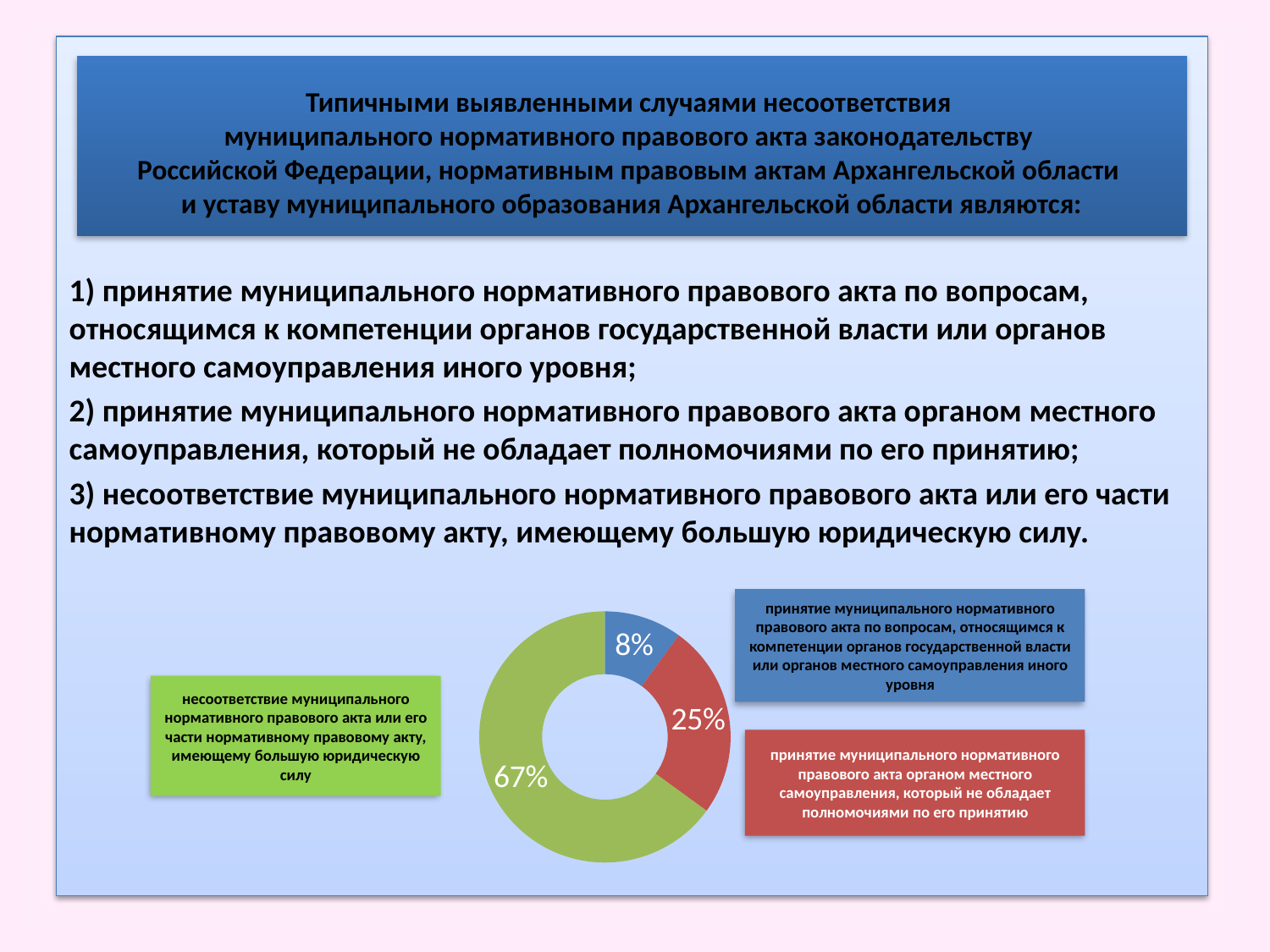
What is the difference in percentage points between the red slice (25%) and the blue slice (8%)? 17 percentage points What percentage is shown for the red slice (принятие муниципального нормативного правового акта органом местного самоуправления, который не обладает полномочиями по его принятию)? 25% What percentage is shown for the green slice (несоответствие муниципального нормативного правового акта или его части нормативному правовому акту, имеющему большую юридическую силу)? 67% What is the difference in percentage points between the green slice (67%) and the red slice (25%)? 42 percentage points What colour is the slice representing 8%? Blue What colour is the slice representing 67%? Green What percentage is shown for the blue slice (принятие муниципального нормативного правового акта по вопросам, относящимся к компетенции органов государственной власти или органов местного самоуправления иного уровня)? 8% Which category has the smallest share in the doughnut chart? принятие муниципального нормативного правового акта по вопросам, относящимся к компетенции органов государственной власти или органов местного самоуправления иного уровня (8%) What kind of chart is shown at the bottom of the slide? Doughnut (pie) chart How many slices does the doughnut chart have? 3 Which category has the largest share in the doughnut chart? несоответствие муниципального нормативного правового акта или его части нормативному правовому акту, имеющему большую юридическую силу (67%) Which slice is larger: the red one or the blue one? The red one (25%)